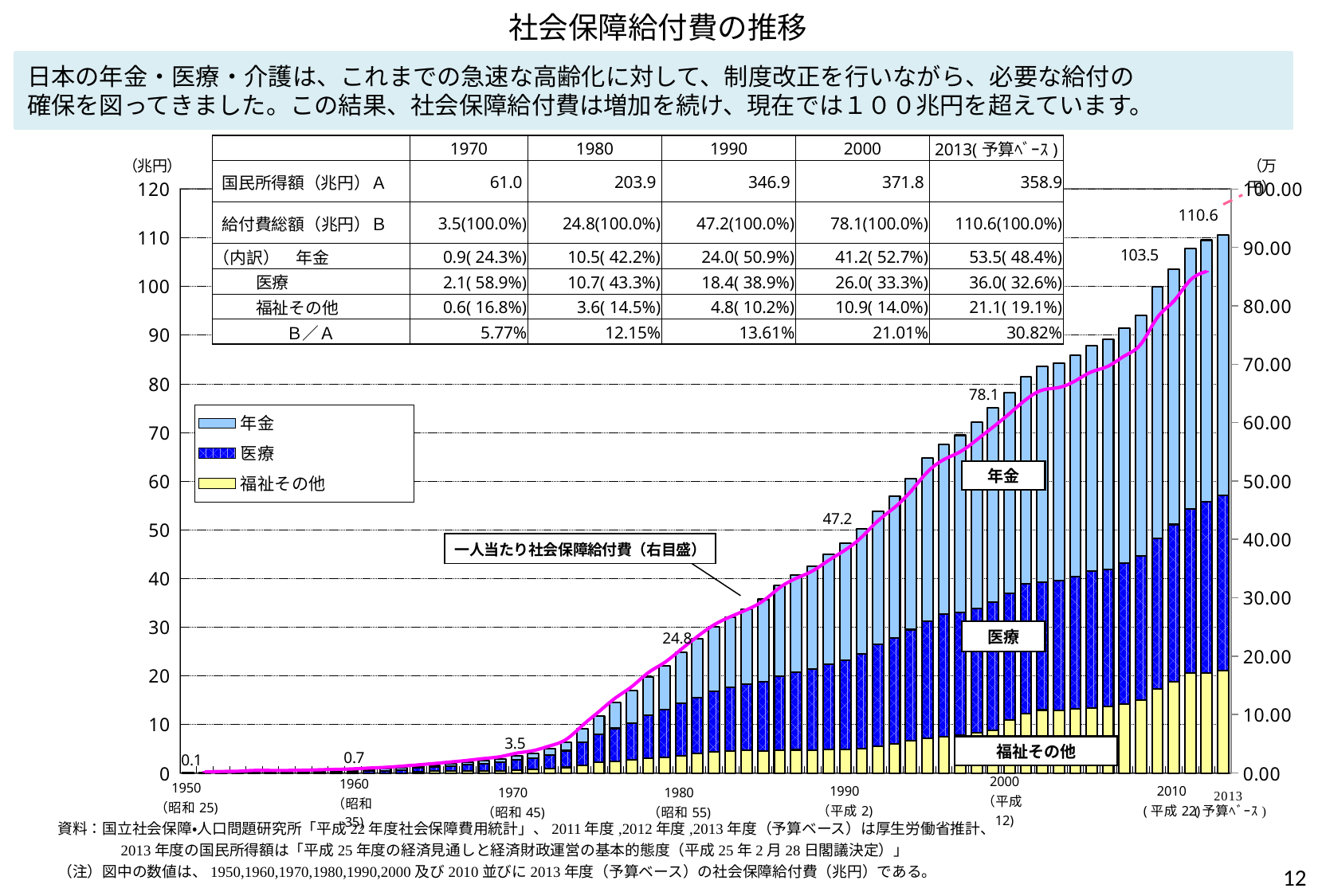
By how much does the labelled value for 2013 exceed the labelled value for 2010? 7.1 What value is labelled on the bar for 2000 in the chart? 78.1 How many series does the legend of the chart list? 3 Which year has the larger labelled value, 1990 or 1980? 1990 What value is labelled on the bar for 1980 in the chart? 24.8 Which series is shown at the bottom of each stacked bar? 福祉その他 What kind of chart is used to show the social security benefit components? bar chart Do the stacked bar totals rise or fall from 1950 to 2013? rise What is the total social security benefit value (兆円) labelled for 2013 (予算ベース) in the chart? 110.6 Which labelled year has the highest total social security benefit in the chart? 2013 What is the difference between the labelled values for 2000 and 1990? 30.9 What value is labelled on the bar for 1970 in the chart? 3.5